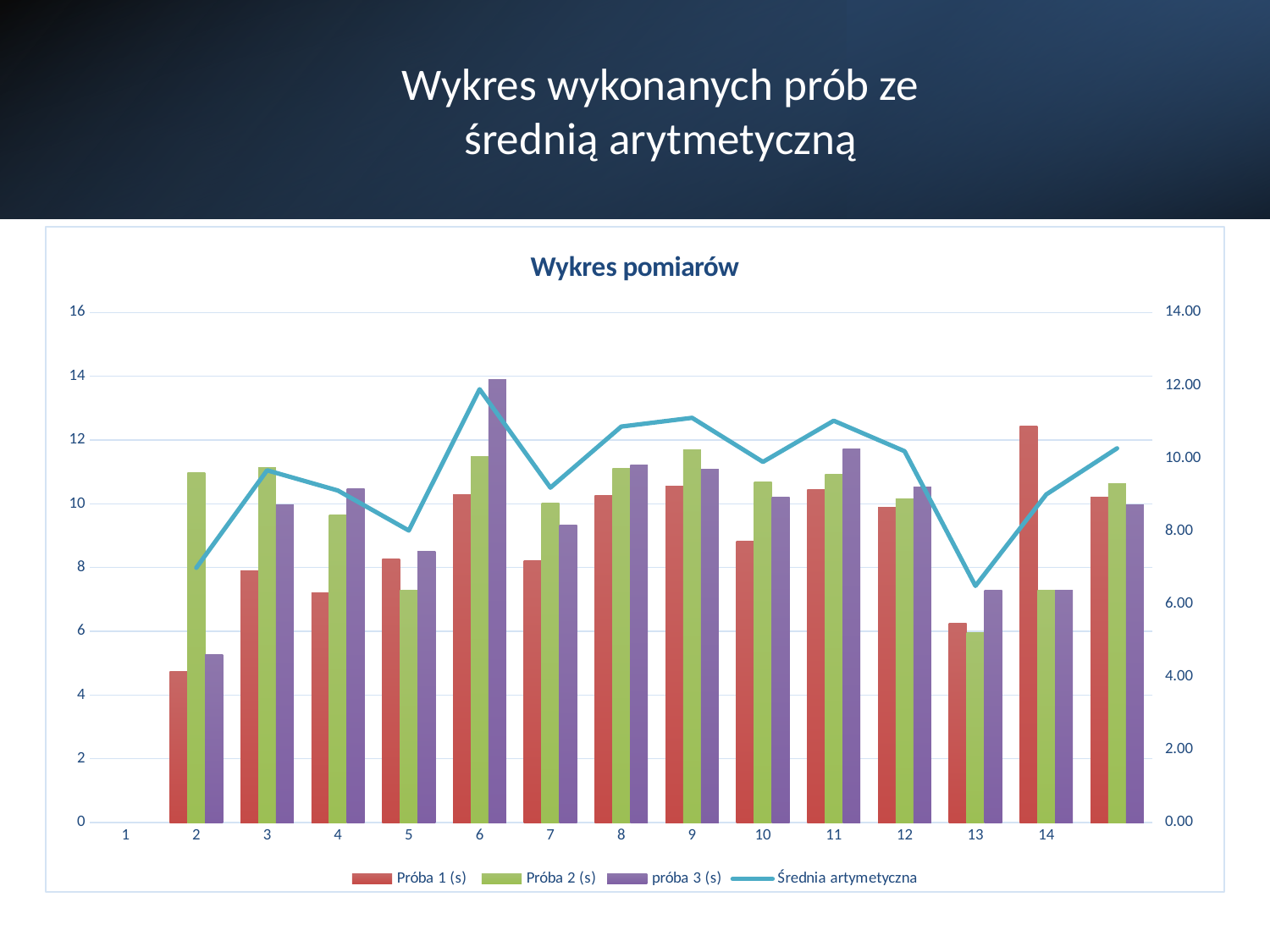
In 'Wykres pomiarów', at which x-axis category is the próba 3 (s) bar highest? 6 In 'Wykres pomiarów', at which x-axis category is the Próba 1 (s) bar highest? 14 What is the title of the chart on the slide? Wykres pomiarów Which series in 'Wykres pomiarów' is drawn as a line rather than bars? Średnia artymetyczna How many series does the legend of 'Wykres pomiarów' list? 4 In 'Wykres pomiarów', at which x-axis category is the Próba 1 (s) bar lowest? 2 In 'Wykres pomiarów', is the Próba 2 (s) value at category 2 greater or less than 10? greater In 'Wykres pomiarów', at category 2, which is larger: Próba 1 (s) or Próba 2 (s)? Próba 2 (s) What kind of chart is 'Wykres pomiarów'? bar chart with a line In 'Wykres pomiarów', is the Próba 1 (s) value at category 2 greater or less than 6? less In 'Wykres pomiarów', at which x-axis category does the Średnia arytmetyczna line reach its highest point? 6 In 'Wykres pomiarów', is the próba 3 (s) value at category 6 greater or less than 12? greater